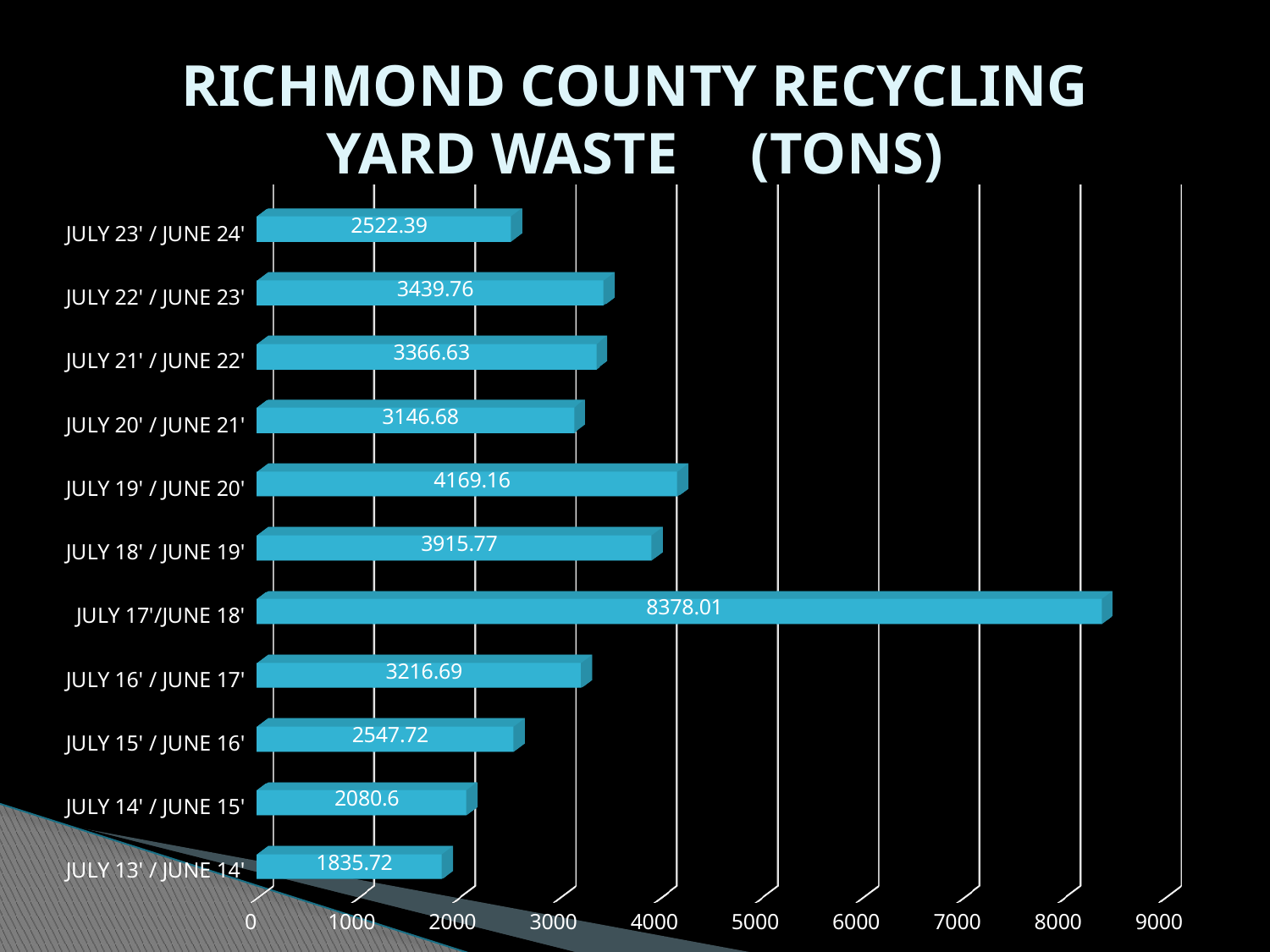
What is the difference between the values for JULY 14' / JUNE 15' and JULY 13' / JUNE 14'? 244.88 What is the yard waste value for JULY 23' / JUNE 24'? 2522.39 What is the difference between the values for JULY 19' / JUNE 20' and JULY 18' / JUNE 19'? 253.39 Which is larger, the value for JULY 22' / JUNE 23' or JULY 21' / JUNE 22'? JULY 22' / JUNE 23' What is the yard waste value for JULY 17'/JUNE 18'? 8378.01 What is the title of the chart? RICHMOND COUNTY RECYCLING YARD WASTE (TONS) What is the yard waste value for JULY 13' / JUNE 14'? 1835.72 How many periods are shown on the chart? 11 Is the value for JULY 20' / JUNE 21' greater or less than 3000? greater Which period has the lowest yard waste tonnage? JULY 13' / JUNE 14' What kind of chart is shown on the slide? bar chart Which period has the highest yard waste tonnage? JULY 17'/JUNE 18'